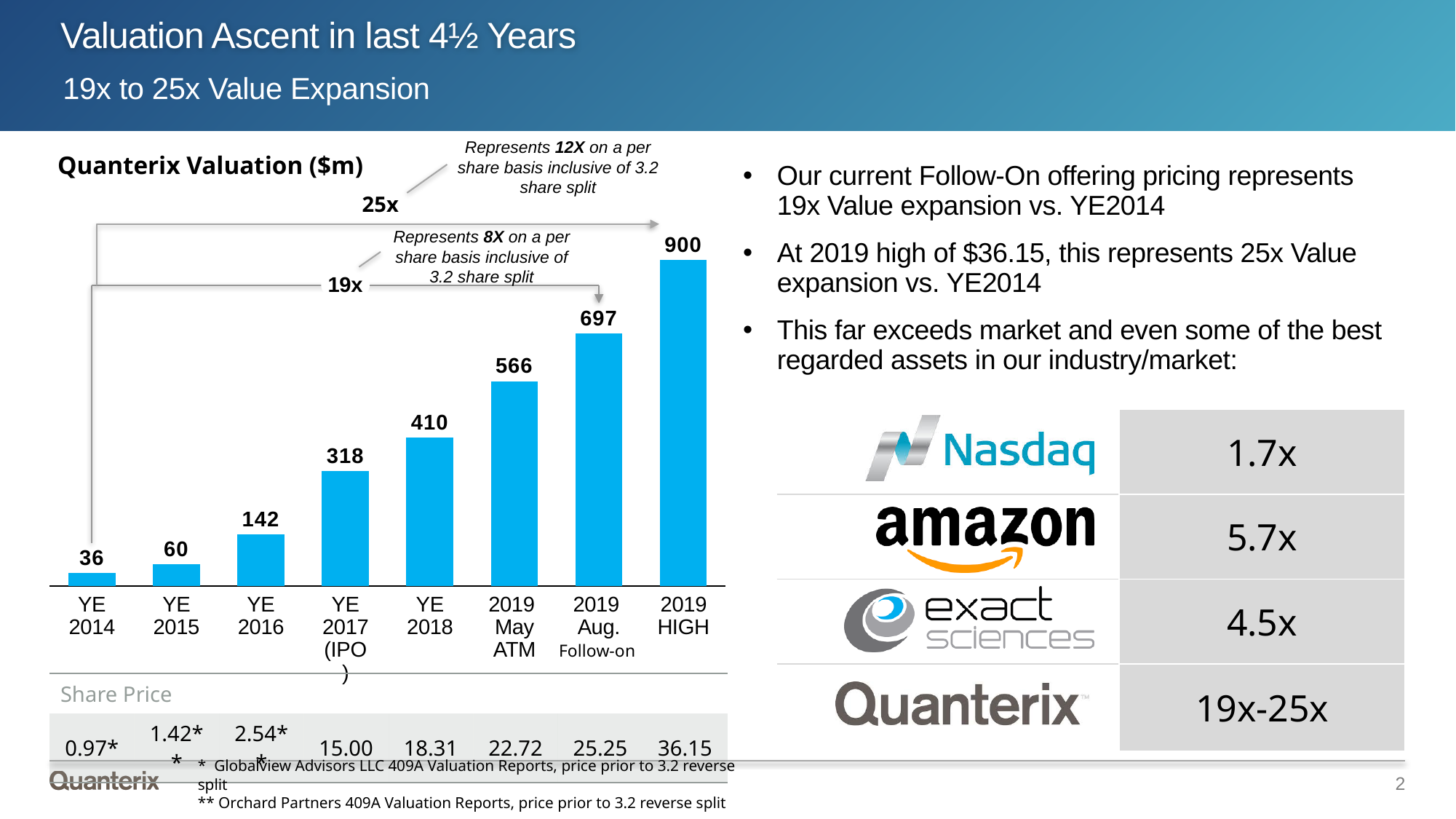
What is the title of the chart on the left of the slide? Quanterix Valuation ($m) What is the difference in valuation ($m) between 2019 HIGH and 2019 Aug. Follow-on? 203 How many categories are shown on the x axis of the Quanterix Valuation chart? 8 What kind of chart is the Quanterix Valuation chart? bar chart What is the difference in valuation ($m) between YE 2018 and YE 2017 (IPO)? 92 Which is larger, the valuation for YE 2016 or YE 2015? YE 2016 Do the valuation values rise or fall from YE 2014 to 2019 HIGH? rise Which category has the highest Quanterix valuation? 2019 HIGH What is the Quanterix valuation ($m) for 2019 Aug. Follow-on? 697 What is the Quanterix valuation ($m) for YE 2017 (IPO)? 318 Which category has the lowest Quanterix valuation? YE 2014 What is the Quanterix valuation ($m) for YE 2014? 36